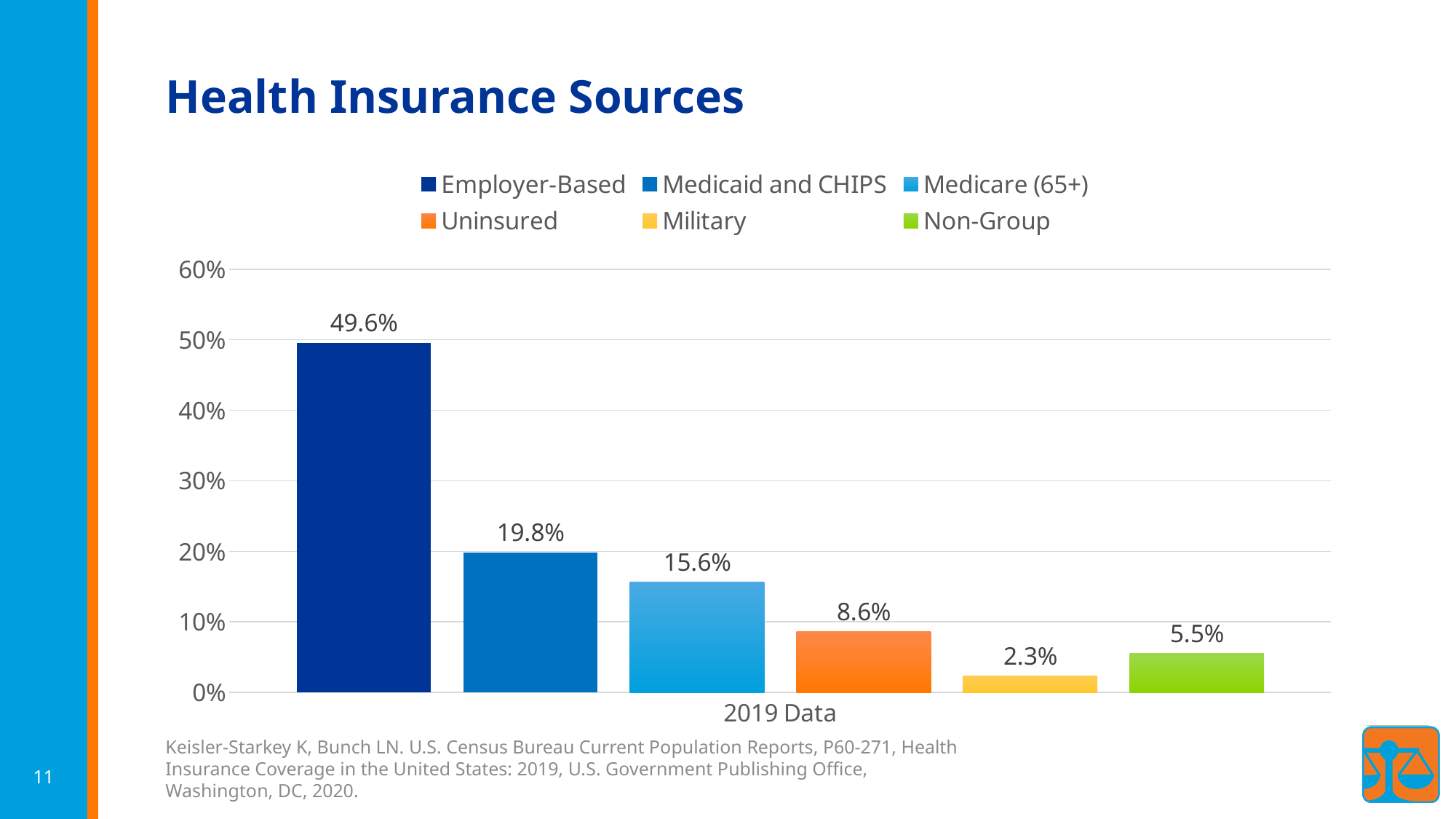
Which source has the highest value? Employer-Based What is the value for Employer-Based? 49.6% What is the difference between the Employer-Based and Medicaid and CHIPS values? 29.8% Which source has the lowest value? Military Which is larger, Uninsured or Non-Group? Uninsured What is the value for Medicare (65+)? 15.6% How many series does the legend list? 6 What is the value for Medicaid and CHIPS? 19.8% What is the value for Non-Group? 5.5% What is the title of the chart? Health Insurance Sources What is the value for Uninsured? 8.6% What kind of chart is shown? Bar chart